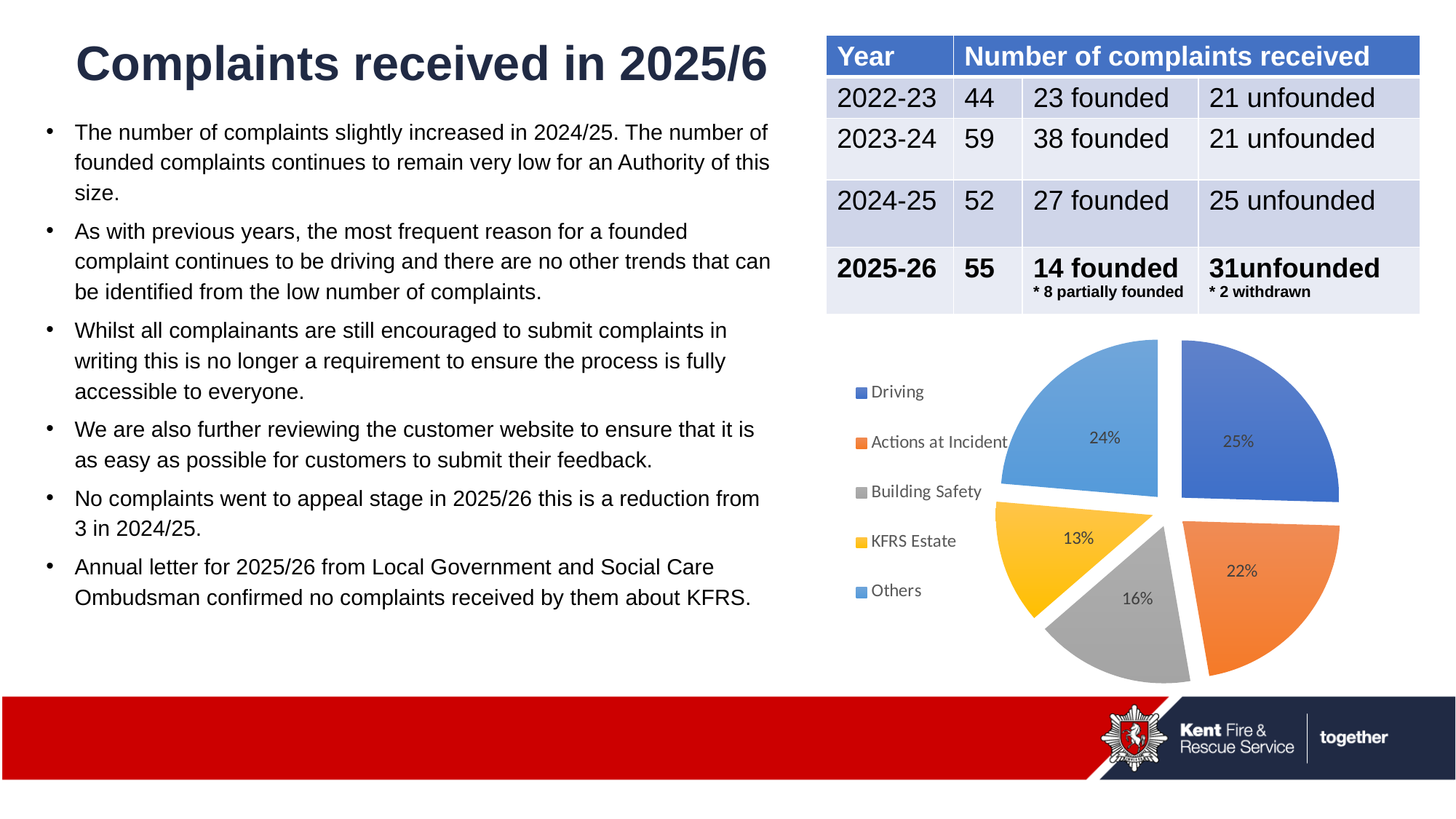
Which has a larger share of the pie chart, Building Safety or Others? Others What percentage of the pie chart is KFRS Estate? 13% How many categories does the pie chart show? 5 Which category has the smallest share of the pie chart? KFRS Estate What percentage of the pie chart is Driving? 25% What colour is the Building Safety slice in the pie chart? grey What percentage of the pie chart is Actions at Incident? 22% What kind of chart is shown on the slide? pie chart Which category has the largest share of the pie chart? Driving What is the difference in percentage points between Actions at Incident and KFRS Estate in the pie chart? 9 What percentage of the pie chart is Others? 24% What percentage of the pie chart is Building Safety? 16%